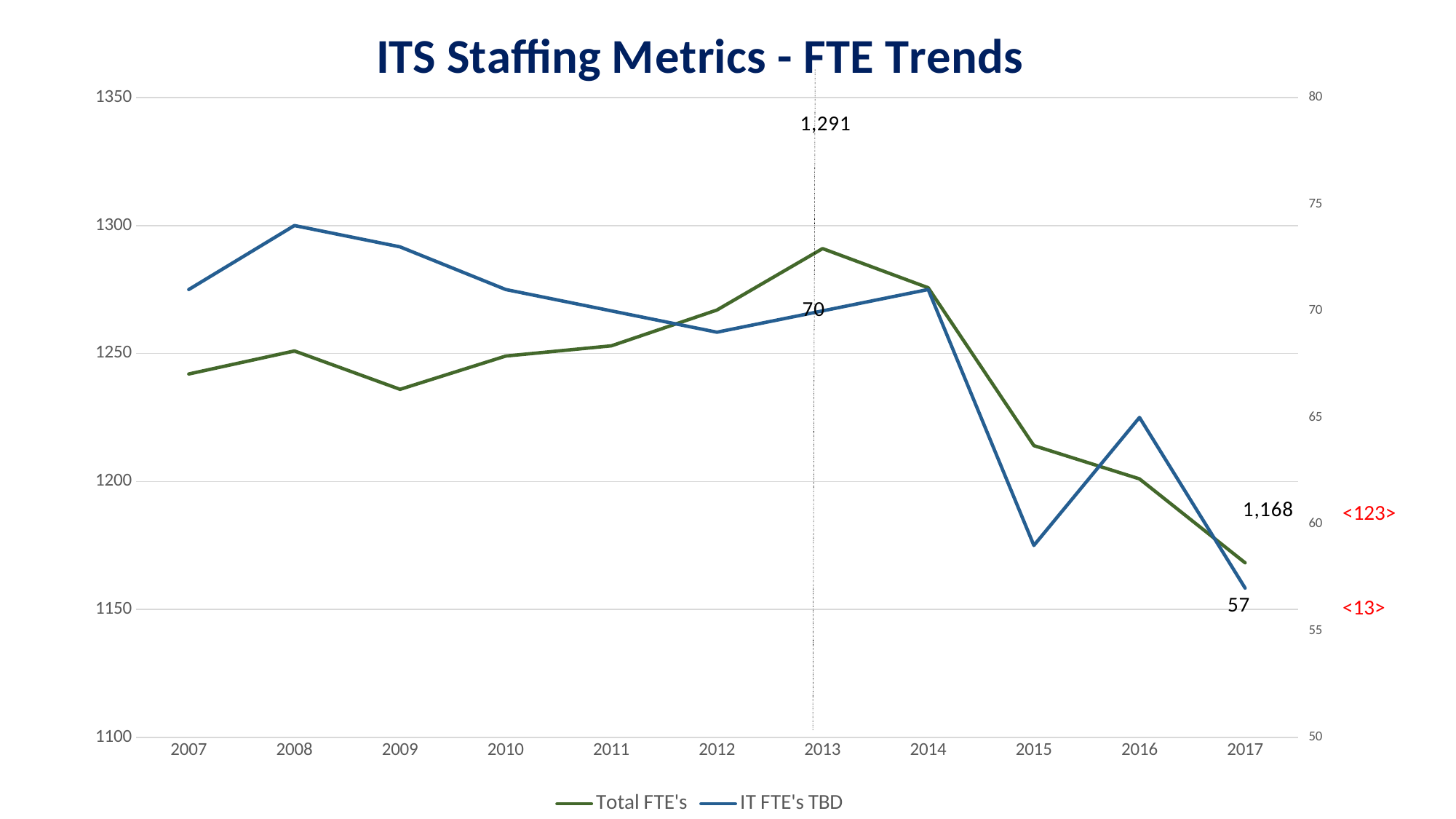
What is the value of Total FTE's in 2013? 1,291 What is the value of IT FTE's TBD in 2013? 70 What is the value of IT FTE's TBD in 2017? 57 Does Total FTE's rise or fall from 2014 to 2017? fall Is the value for Total FTE's in 2015 greater or less than 1200? greater What is the value of Total FTE's in 2017? 1,168 How many years are plotted along the x axis? 11 By how much did Total FTE's fall from 2013 to 2017? 123 How many series does the legend list? 2 In which year is Total FTE's at its highest? 2013 What kind of chart is shown on the slide? line chart By how much did IT FTE's TBD fall from 2013 to 2017? 13